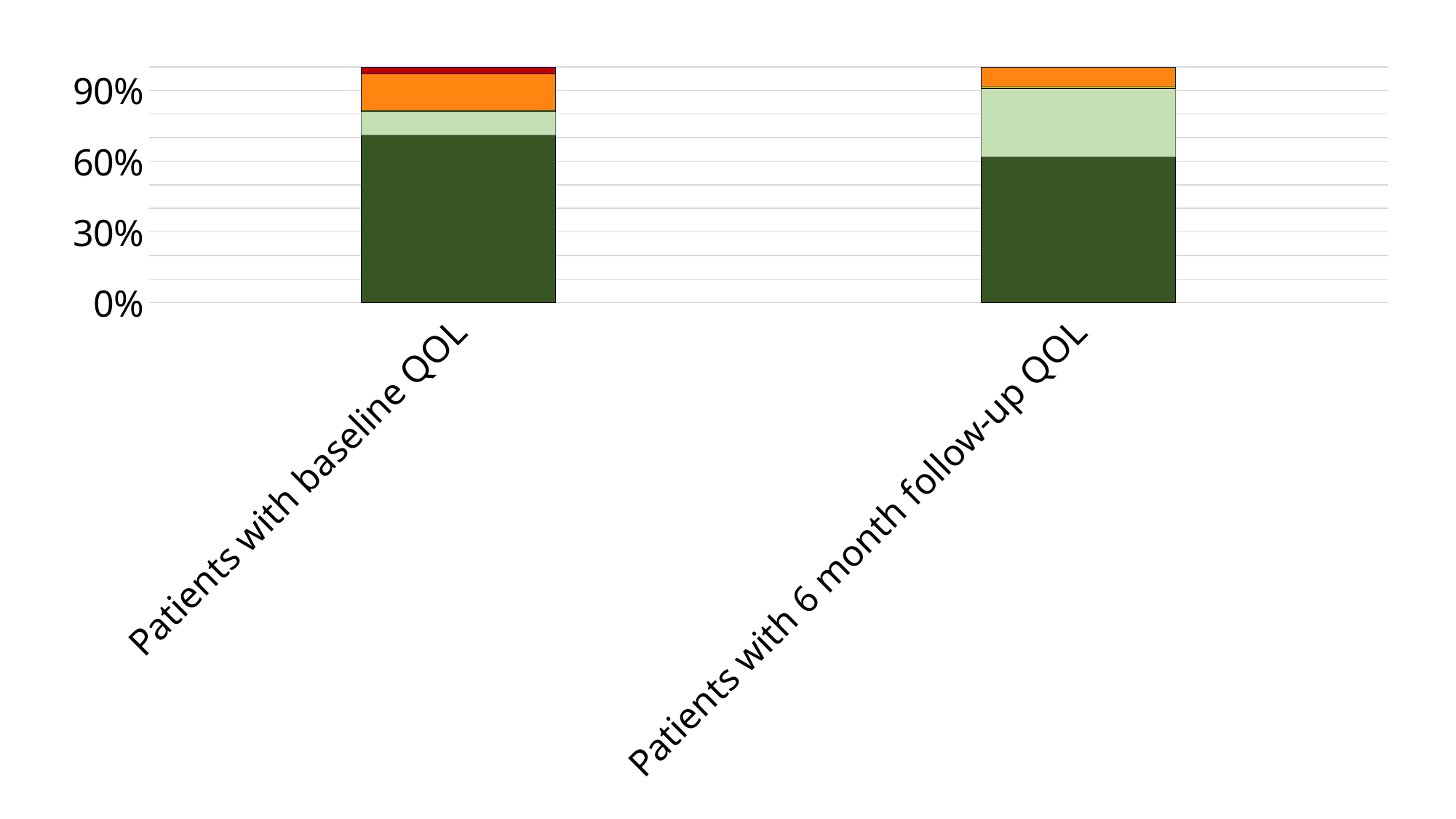
Which category has the larger orange segment? Patients with baseline QOL Does the dark green bottom segment rise or fall from the baseline category to the 6 month follow-up category? Fall Is the dark green bottom segment for Patients with baseline QOL greater or less than 90%? less What kind of chart is shown on the slide? Stacked bar chart What are the two category labels on the x axis? Patients with baseline QOL; Patients with 6 month follow-up QOL Which category has the larger light green segment? Patients with 6 month follow-up QOL What is the highest tick label shown on the y axis? 90% Is the dark green bottom segment for Patients with 6 month follow-up QOL greater or less than 30%? greater Which category has the larger dark green bottom segment? Patients with baseline QOL Which category includes a red segment at the top of its bar? Patients with baseline QOL How many categories are plotted on the x axis? 2 Is the dark green bottom segment for Patients with baseline QOL greater or less than 60%? greater